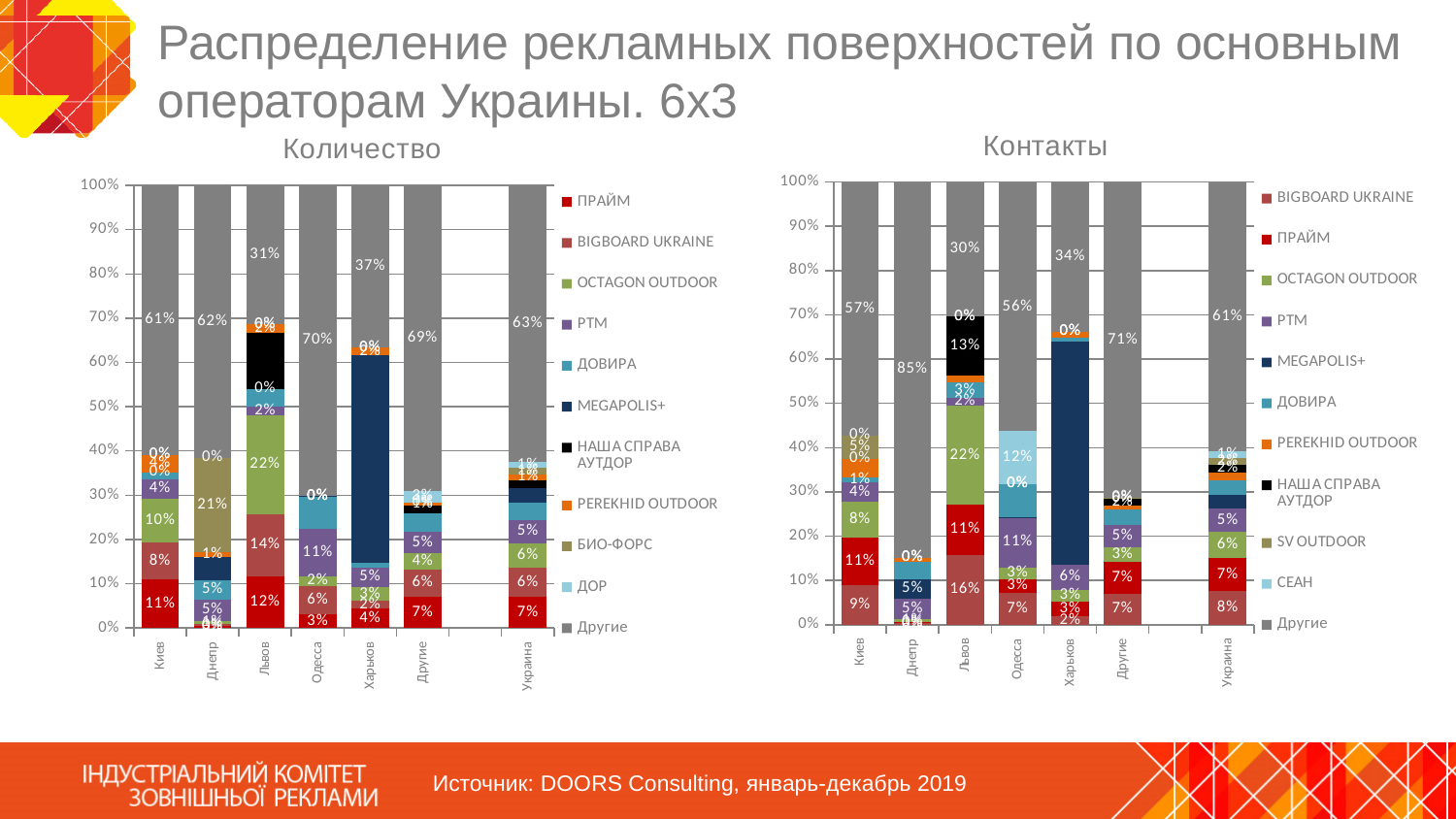
In the "Количество" chart, which city has the highest "Другие" share? Одесса In the "Контакты" chart, which category has the lowest "Другие" share? Львов In the "Количество" chart, what is the ПРАЙМ value for Украина? 7% In the "Количество" chart, what is the difference between the OCTAGON OUTDOOR values for Львов and Киев? 12% What kind of chart is the "Количество" chart on the left? Stacked bar chart How many categories are shown on the x axis of the "Контакты" chart? 7 What is the title of the chart on the right side of the slide? Контакты In the "Контакты" chart, what is the value of the "Другие" segment for Днепр? 85% In the "Контакты" chart, which is larger for Львов: BIGBOARD UKRAINE or ПРАЙМ? BIGBOARD UKRAINE In the "Контакты" chart, what is the СЕАН value for Одесса? 12% How many series does the legend of the "Количество" chart list? 11 In the "Количество" chart, what is the value of the "Другие" segment for Львов? 31%